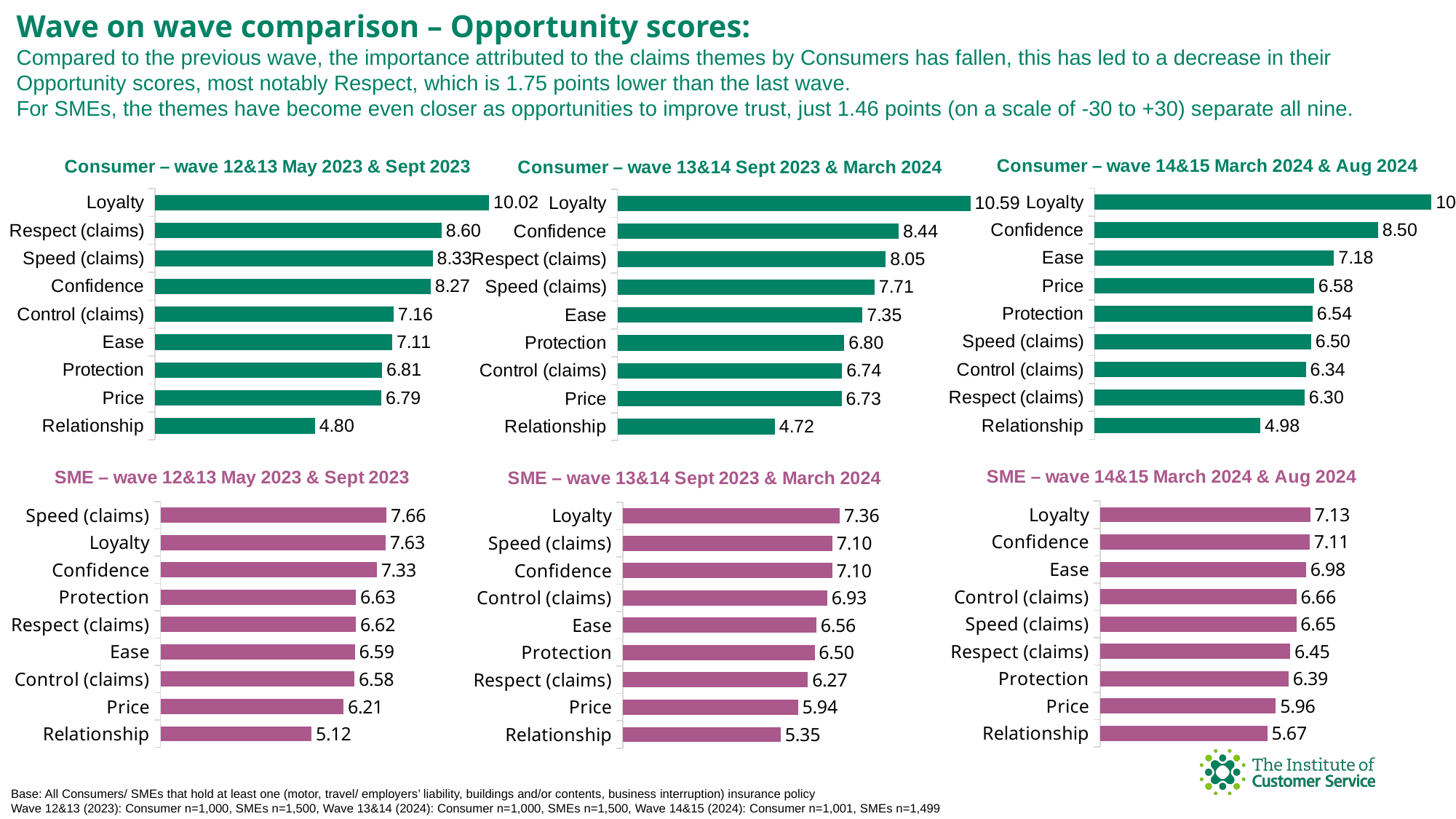
In the 'Consumer – wave 12&13 May 2023 & Sept 2023' chart, what is the value for Respect (claims)? 8.60 In the 'SME – wave 14&15 March 2024 & Aug 2024' chart, which is larger, Ease or Control (claims)? Ease In the 'Consumer – wave 13&14 Sept 2023 & March 2024' chart, which category has the highest value? Loyalty How many charts are shown on the slide? 6 What kind of chart is the 'SME – wave 13&14 Sept 2023 & March 2024' chart? Bar chart In the 'SME – wave 12&13 May 2023 & Sept 2023' chart, which category has the lowest value? Relationship In the 'Consumer – wave 14&15 March 2024 & Aug 2024' chart, what is the value for Confidence? 8.50 In the 'SME – wave 12&13 May 2023 & Sept 2023' chart, what is the value for Price? 6.21 In the 'SME – wave 13&14 Sept 2023 & March 2024' chart, what is the value for Relationship? 5.35 In the 'Consumer – wave 13&14 Sept 2023 & March 2024' chart, what is the difference between Loyalty and Confidence? 2.15 How many categories are shown in the 'Consumer – wave 14&15 March 2024 & Aug 2024' chart? 9 In the 'SME – wave 14&15 March 2024 & Aug 2024' chart, what is the difference between Loyalty and Relationship? 1.46